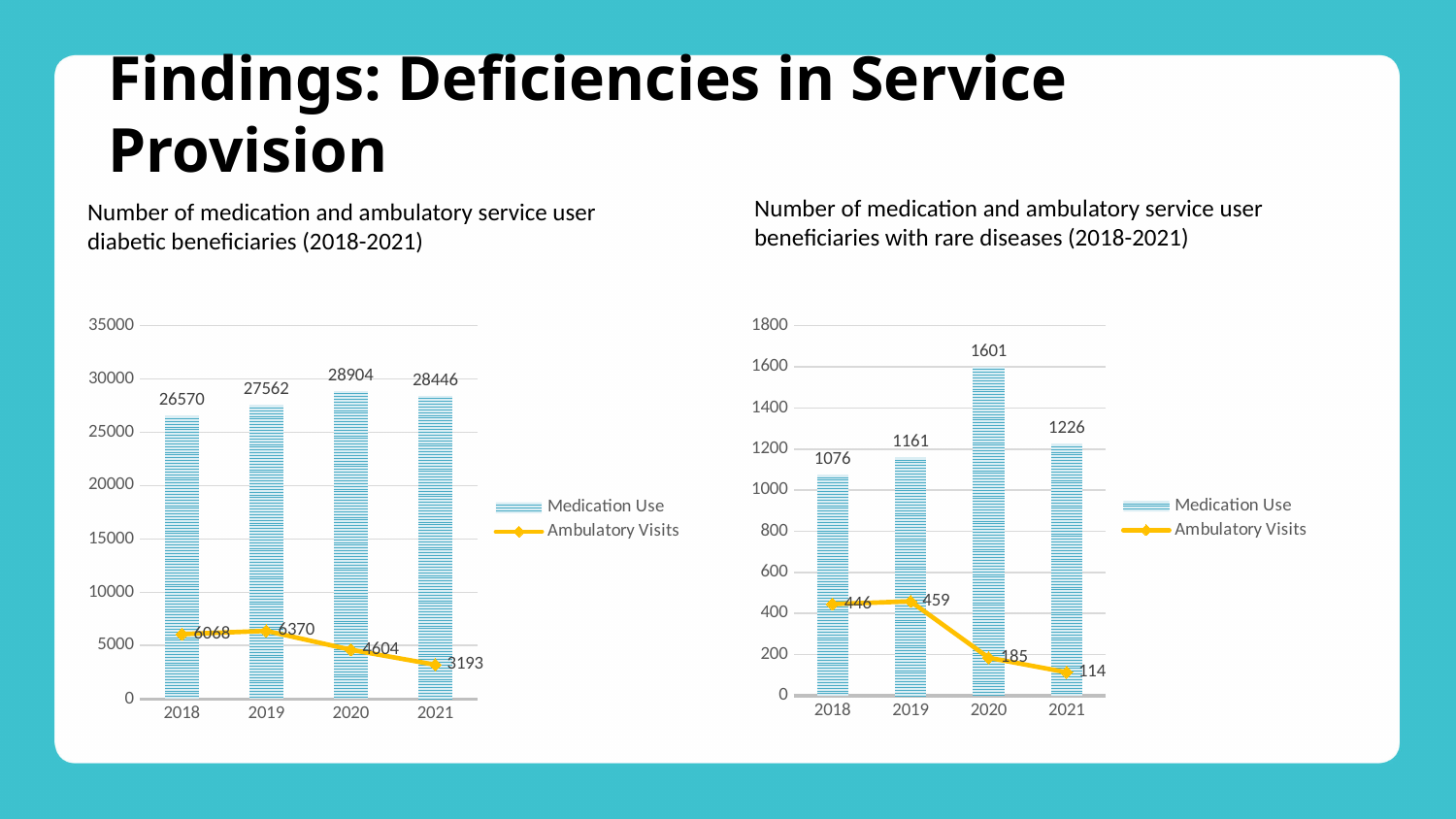
In the chart on beneficiaries with rare diseases, what is the Medication Use value for 2021? 1226 In the chart on diabetic beneficiaries, which year has the highest Medication Use? 2020 In the chart on beneficiaries with rare diseases, what is the Ambulatory Visits value for 2020? 185 In the chart on diabetic beneficiaries, what is the Medication Use value for 2020? 28904 In the chart on diabetic beneficiaries, do Ambulatory Visits rise or fall from 2019 to 2021? fall In the chart on beneficiaries with rare diseases, which year has the lowest Ambulatory Visits? 2021 In the chart on beneficiaries with rare diseases, is Medication Use higher in 2019 or 2021? 2021 In the chart on beneficiaries with rare diseases, what is the difference between Medication Use in 2020 and 2018? 525 How many series does the legend list in the chart on beneficiaries with rare diseases? 2 How many years are shown on the x axis of the chart on diabetic beneficiaries? 4 In the chart on diabetic beneficiaries, what is the Ambulatory Visits value for 2021? 3193 In the chart on diabetic beneficiaries, what is the difference between Ambulatory Visits in 2019 and 2021? 3177